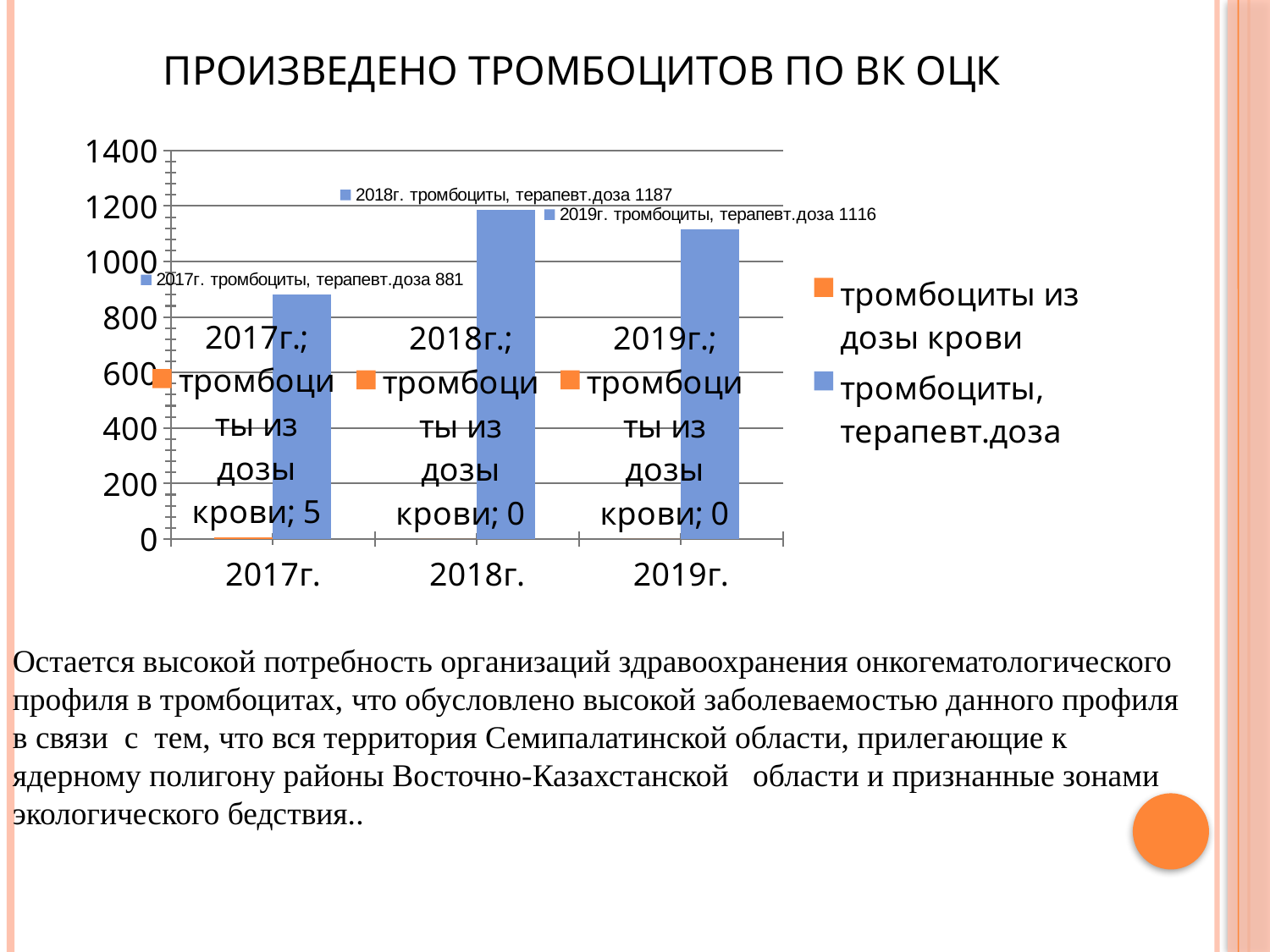
What is the value of тромбоциты из дозы крови for 2017г.? 5 What is the value of тромбоциты, терапевт.доза for 2018г.? 1187 What is the value of тромбоциты, терапевт.доза for 2017г.? 881 What is the value of тромбоциты из дозы крови for 2019г.? 0 What is the title of the chart? ПРОИЗВЕДЕНО ТРОМБОЦИТОВ ПО ВК ОЦК Which year has the lowest value of тромбоциты, терапевт.доза? 2017г. What type of chart is shown on the slide? bar chart Is the value of тромбоциты, терапевт.доза for 2017г. greater or less than 1000? less How many series does the legend list? 2 Which year has the highest value of тромбоциты, терапевт.доза? 2018г. What is the difference between the тромбоциты, терапевт.доза values for 2018г. and 2019г.? 71 What is the value of тромбоциты, терапевт.доза for 2019г.? 1116